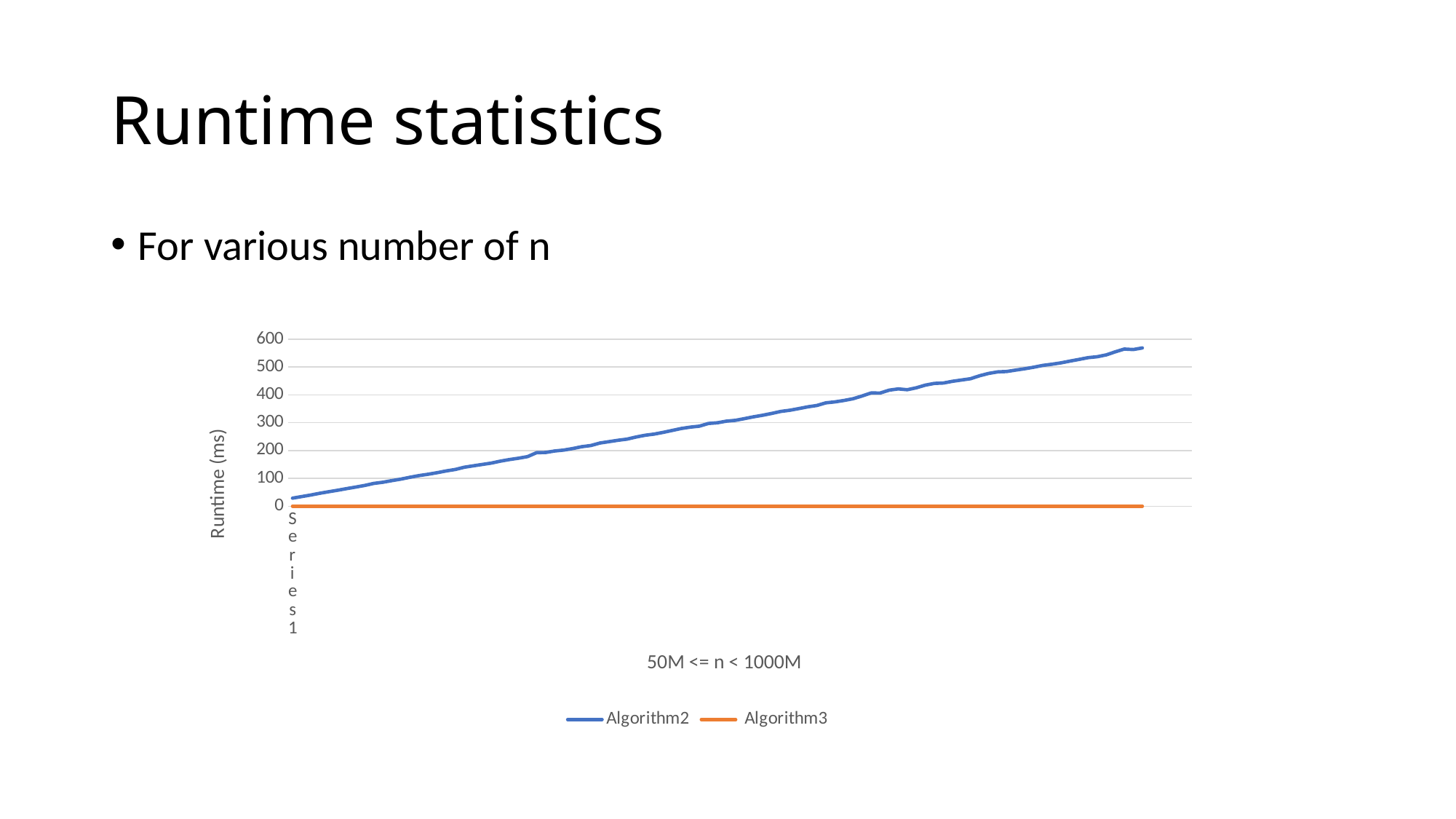
Which series has the lowest runtime throughout the chart? Algorithm3 Is the highest value for Algorithm2 greater or less than 600? less Is the highest value for Algorithm2 greater or less than 500? greater Does the runtime for Algorithm3 rise, fall, or stay flat along the x axis? stay flat What is the title of the vertical axis? Runtime (ms) Is the value for Algorithm2 at the start of the x axis greater or less than 100? less How many series does the legend list? 2 Does the runtime for Algorithm2 rise or fall along the x axis? rise Which series are listed in the legend? Algorithm2 and Algorithm3 Which series has the higher runtime across the chart, Algorithm2 or Algorithm3? Algorithm2 What kind of chart is shown on the slide? line chart